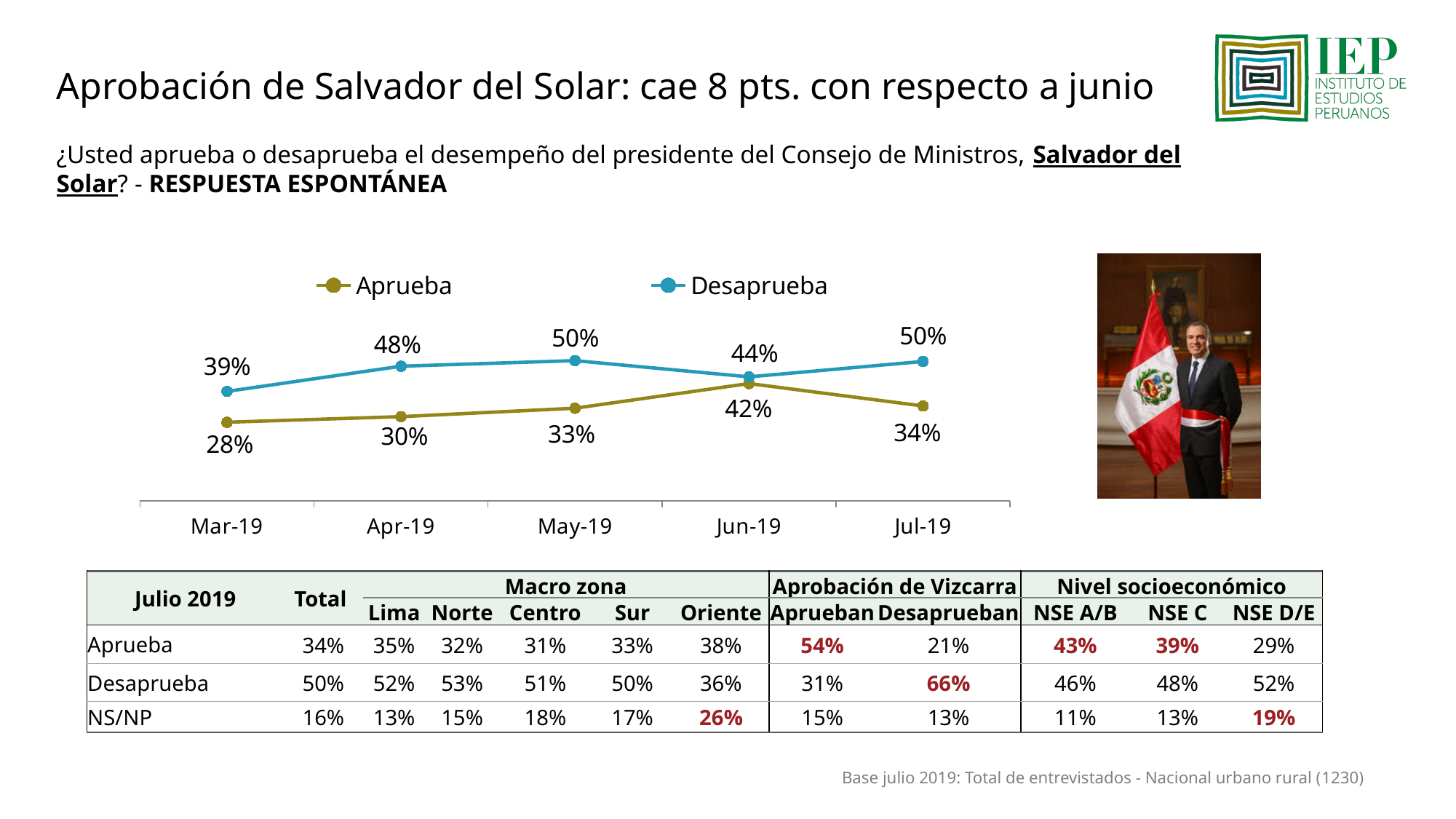
Which is larger in May-19, Aprueba or Desaprueba? Desaprueba In which month is the Desaprueba series at its lowest? Mar-19 How many series does the chart legend list? 2 What colour is the Desaprueba line in the chart? blue What is the Aprueba value for Mar-19? 28% What is the Desaprueba value for Apr-19? 48% What is the difference between the Desaprueba and Aprueba values in Jul-19? 16% In which month is the Aprueba series at its highest? Jun-19 Does the Aprueba series rise or fall from Jun-19 to Jul-19? fall How many months are plotted on the x axis of the chart? 5 What type of chart is shown on the slide? line chart What is the Aprueba value for Jun-19? 42%